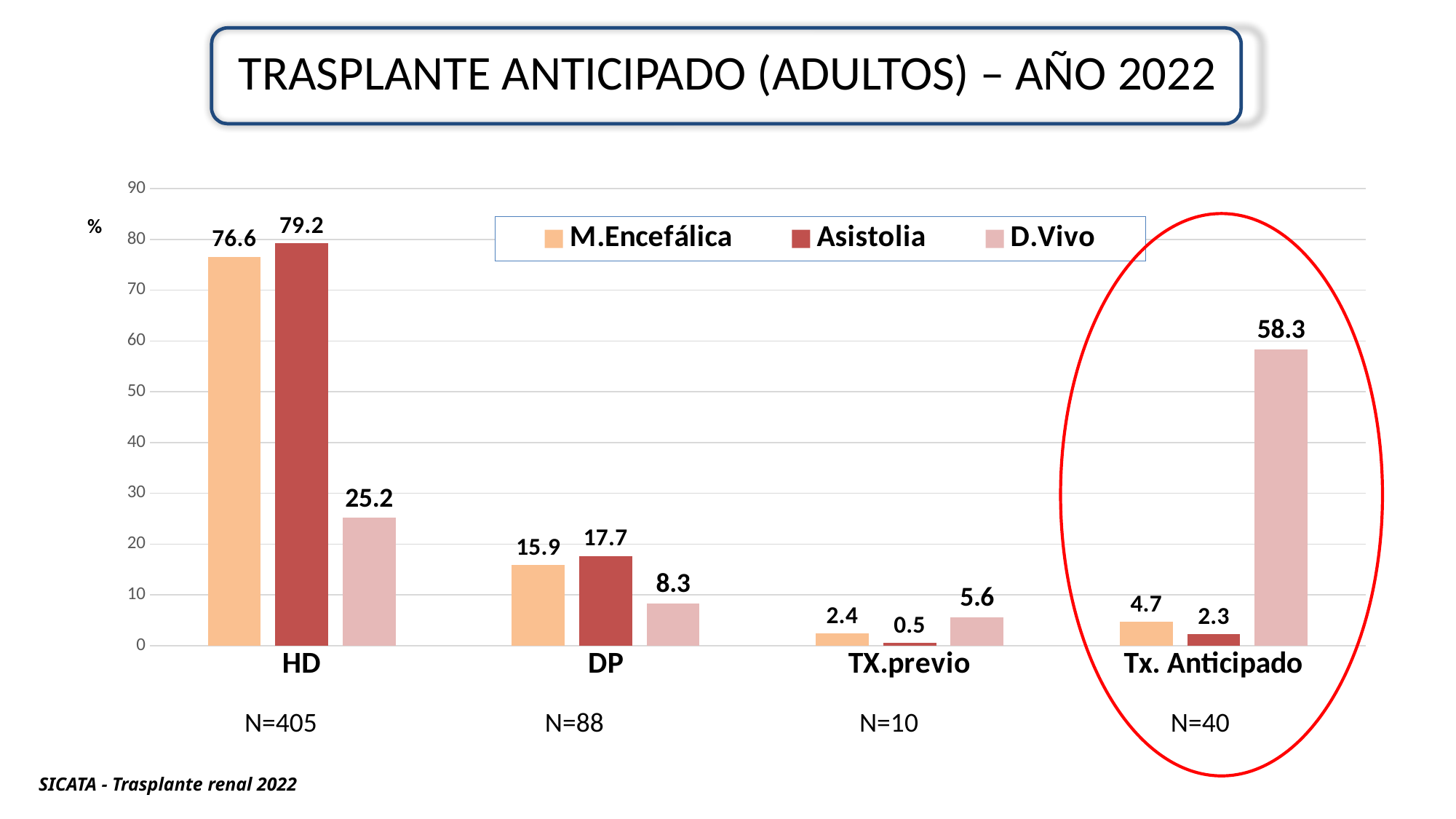
How many series does the legend list? 3 Which category has the lowest value for Asistolia? TX.previo In the DP category, which is larger: Asistolia or D.Vivo? Asistolia What is the N value shown under the Tx. Anticipado category? N=40 What is the value for D.Vivo in the Tx. Anticipado category? 58.3 What is the value for Asistolia in the HD category? 79.2 What is the value for Asistolia in the TX.previo category? 0.5 Which category has the highest value for D.Vivo? Tx. Anticipado What is the difference between the Asistolia and M.Encefálica values in the HD category? 2.6 What kind of chart is shown on the slide? Bar chart How many categories are shown on the x axis? 4 What is the value for M.Encefálica in the DP category? 15.9